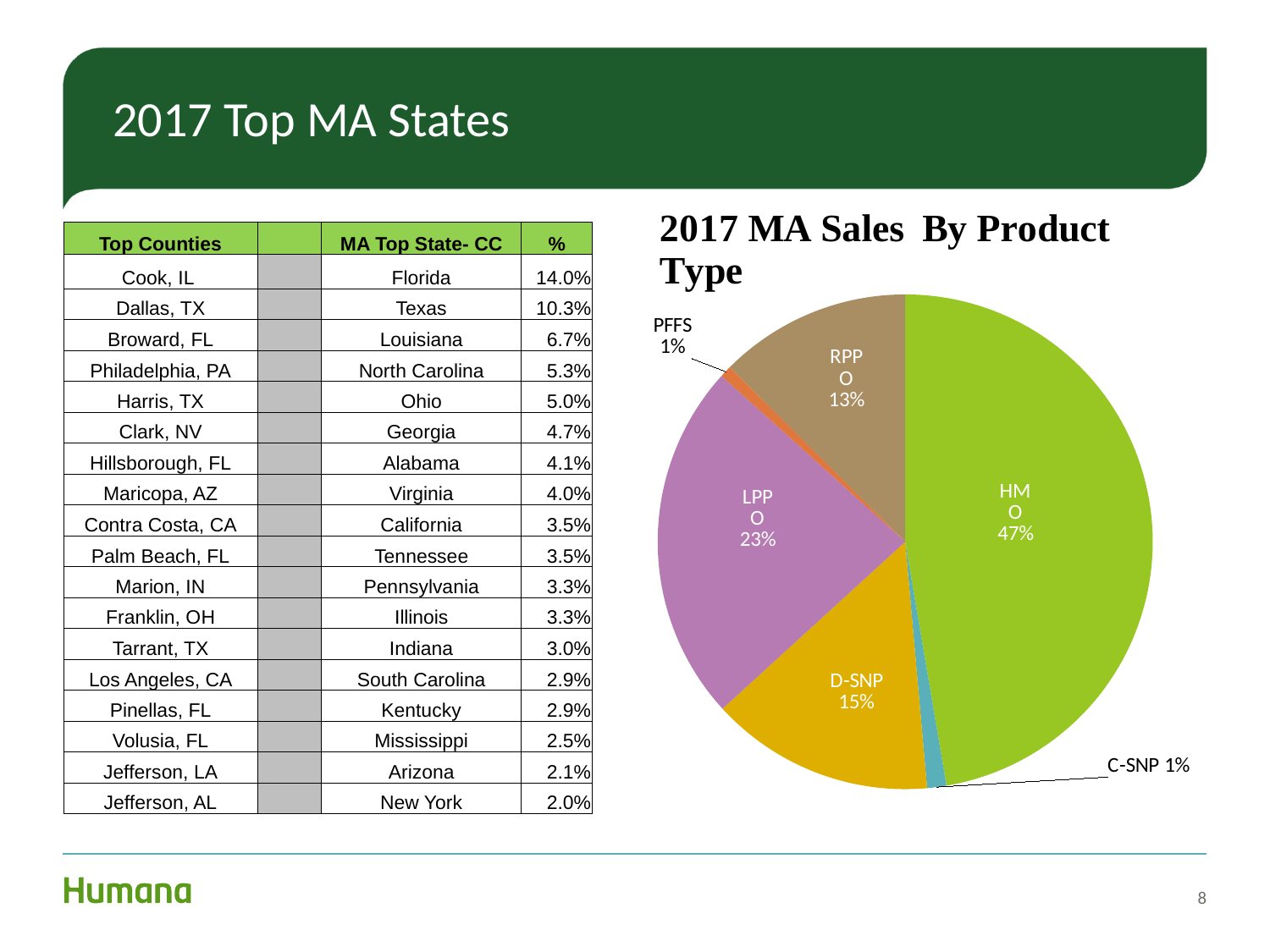
How many slices does the pie chart have? 6 What is the title of the chart on the slide? 2017 MA Sales By Product Type What is the difference in percentage points between HMO and LPPO in the pie chart? 24 What share of 2017 MA sales does HMO account for in the pie chart? 47% Which is larger in the pie chart, LPPO or D-SNP? LPPO What share does D-SNP have in the 2017 MA Sales By Product Type chart? 15% What share does PFFS have in the pie chart? 1% What is the combined share of D-SNP and RPPO in the pie chart? 28% What percentage is shown for RPPO in the pie chart? 13% What type of chart is shown on the slide? Pie chart Which product type has the largest slice of the pie chart? HMO What percentage of the pie chart is LPPO? 23%